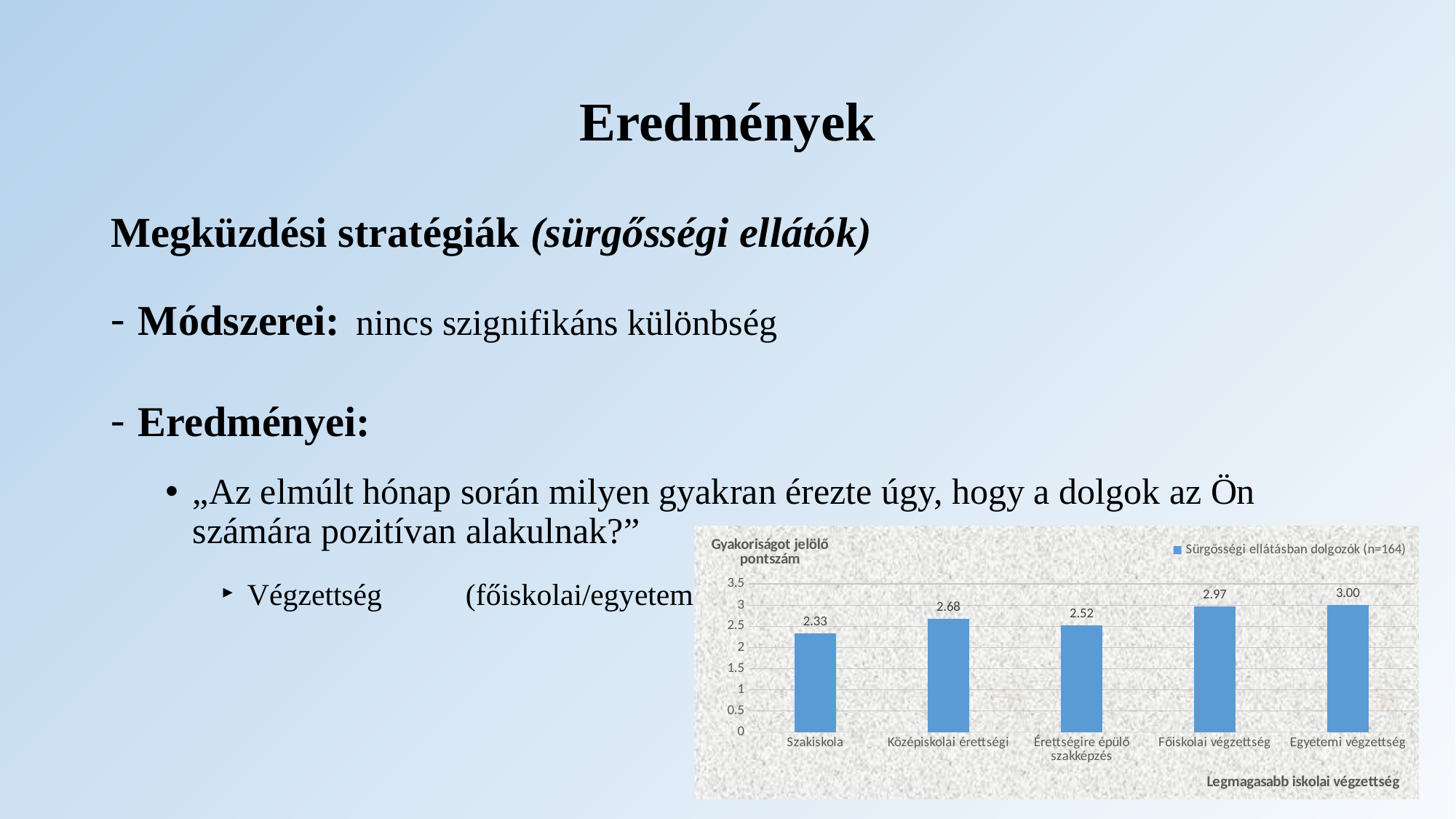
Is the value for Szakiskola greater or less than 2.5? less What is the value for Szakiskola? 2.33 Which category has the highest value? Egyetemi végzettség What is the value for Érettségire épülő szakképzés? 2.52 Which is larger, the value for Középiskolai érettségi or for Érettségire épülő szakképzés? Középiskolai érettségi What is the difference between the values for Egyetemi végzettség and Szakiskola? 0.67 What kind of chart is shown? bar chart How many categories are shown on the x axis? 5 Which category has the lowest value? Szakiskola How many series does the legend list? 1 What is the legend entry of the chart? Sürgősségi ellátásban dolgozók (n=164) What is the value for Főiskolai végzettség? 2.97